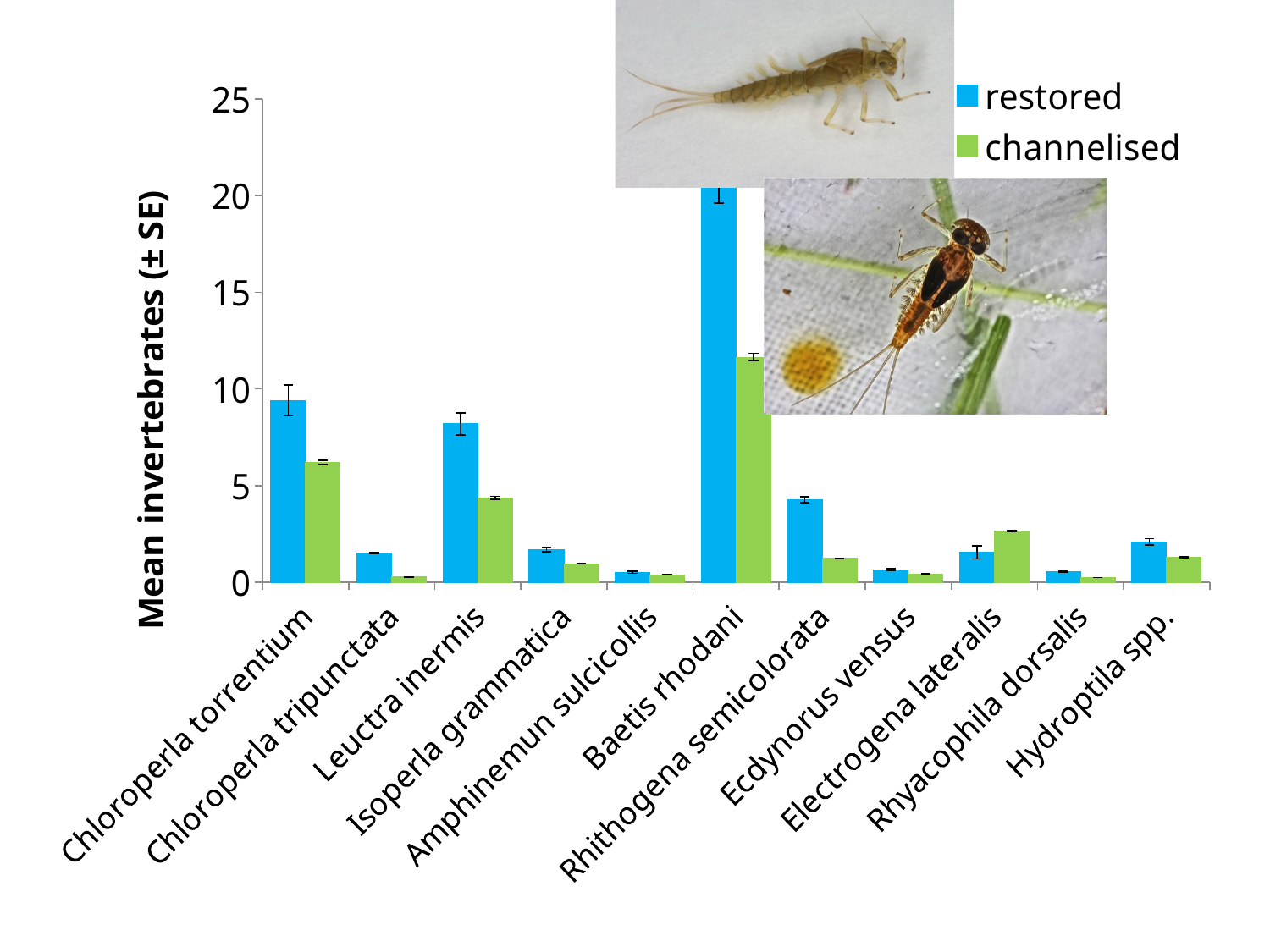
Is the channelised value for Baetis rhodani greater or less than 10? greater Is the channelised value for Leuctra inermis greater or less than 5? less What is the label on the y axis? Mean invertebrates (± SE) How many series does the legend list? 2 For Rhithogena semicolorata, which is larger: the restored value or the channelised value? restored Which species has the highest restored value? Baetis rhodani What kind of chart is shown on the slide? bar chart Which species has the highest channelised value? Baetis rhodani Is the restored value for Chloroperla torrentium greater or less than 5? greater How many species categories are shown on the x axis? 11 For Electrogena lateralis, which is larger: the restored value or the channelised value? channelised